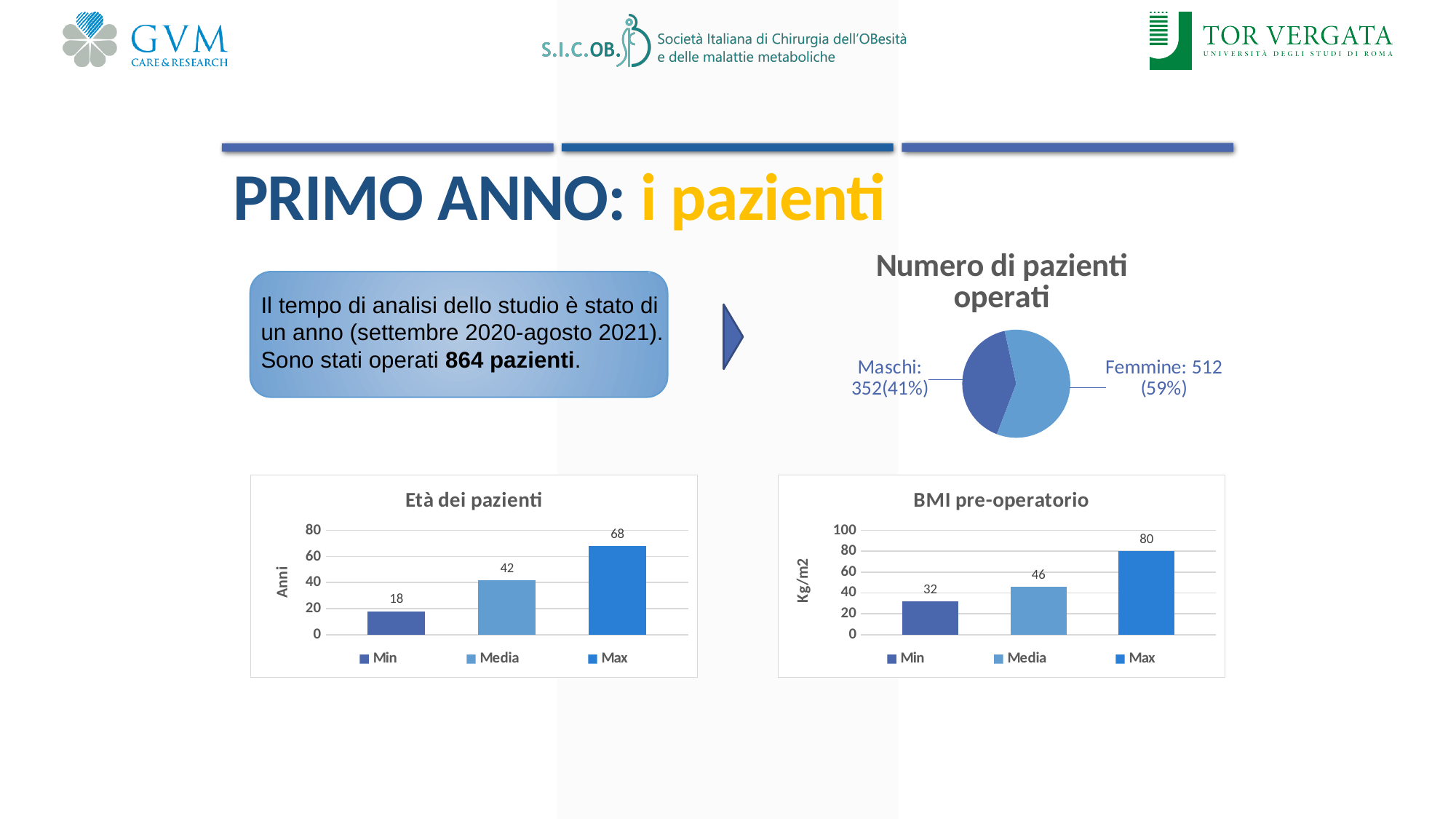
What kind of chart is 'Età dei pazienti'? Bar chart In the 'Numero di pazienti operati' pie chart, what is the value for Femmine? 512 (59%) In the 'Numero di pazienti operati' pie chart, what is the difference between the Femmine and Maschi counts? 160 In the 'Età dei pazienti' chart, which series has the lowest value? Min In the 'BMI pre-operatorio' chart, what is the value for Max? 80 In the 'BMI pre-operatorio' chart, what is the difference between Media and Min? 14 In the 'Numero di pazienti operati' pie chart, which slice is larger, Maschi or Femmine? Femmine In the 'Numero di pazienti operati' pie chart, what share of the pie is Maschi? 41% How many series does the legend of the 'BMI pre-operatorio' chart list? 3 In the 'Età dei pazienti' chart, what is the difference between Max and Min? 50 In the 'Età dei pazienti' chart, what is the value for Media? 42 What is the y-axis label of the 'BMI pre-operatorio' chart? Kg/m2